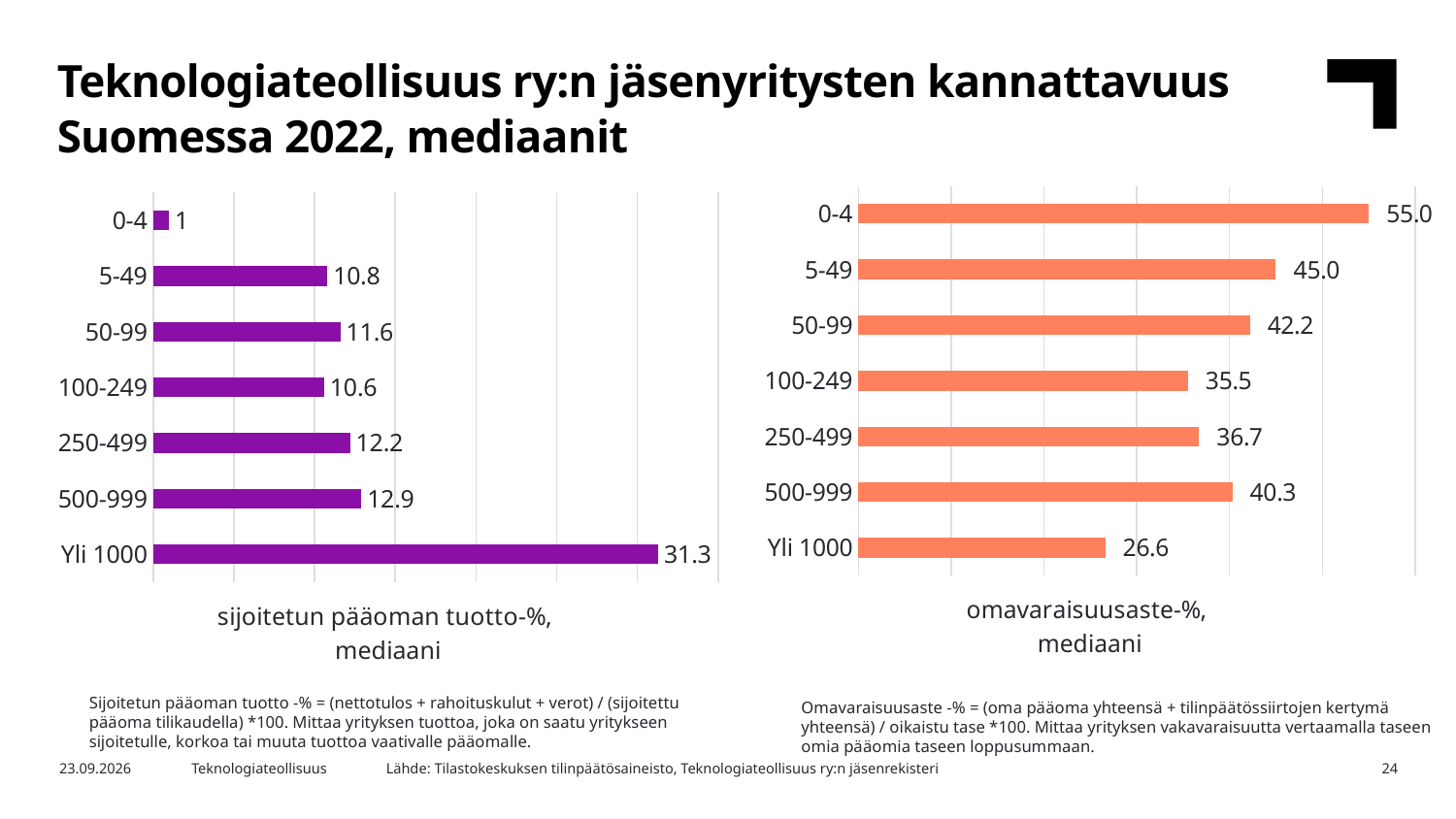
In the left chart (sijoitetun pääoman tuotto-%, mediaani), what is the difference between the values for 500-999 and 250-499? 0.7 In the left chart (sijoitetun pääoman tuotto-%, mediaani), how many categories are shown? 7 What colour are the bars in the right chart (omavaraisuusaste-%, mediaani)? Orange In the right chart (omavaraisuusaste-%, mediaani), which category has the lowest value? Yli 1000 In the right chart (omavaraisuusaste-%, mediaani), which is larger, the value for 250-499 or the value for 500-999? 500-999 In the left chart (sijoitetun pääoman tuotto-%, mediaani), what is the value for 50-99? 11.6 In the left chart (sijoitetun pääoman tuotto-%, mediaani), what is the value for Yli 1000? 31.3 In the right chart (omavaraisuusaste-%, mediaani), what is the difference between the values for 0-4 and 5-49? 10.0 In the left chart (sijoitetun pääoman tuotto-%, mediaani), which category has the lowest value? 0-4 In the right chart (omavaraisuusaste-%, mediaani), which category has the highest value? 0-4 What type of chart is the left chart (sijoitetun pääoman tuotto-%, mediaani)? Bar chart In the right chart (omavaraisuusaste-%, mediaani), what is the value for 100-249? 35.5